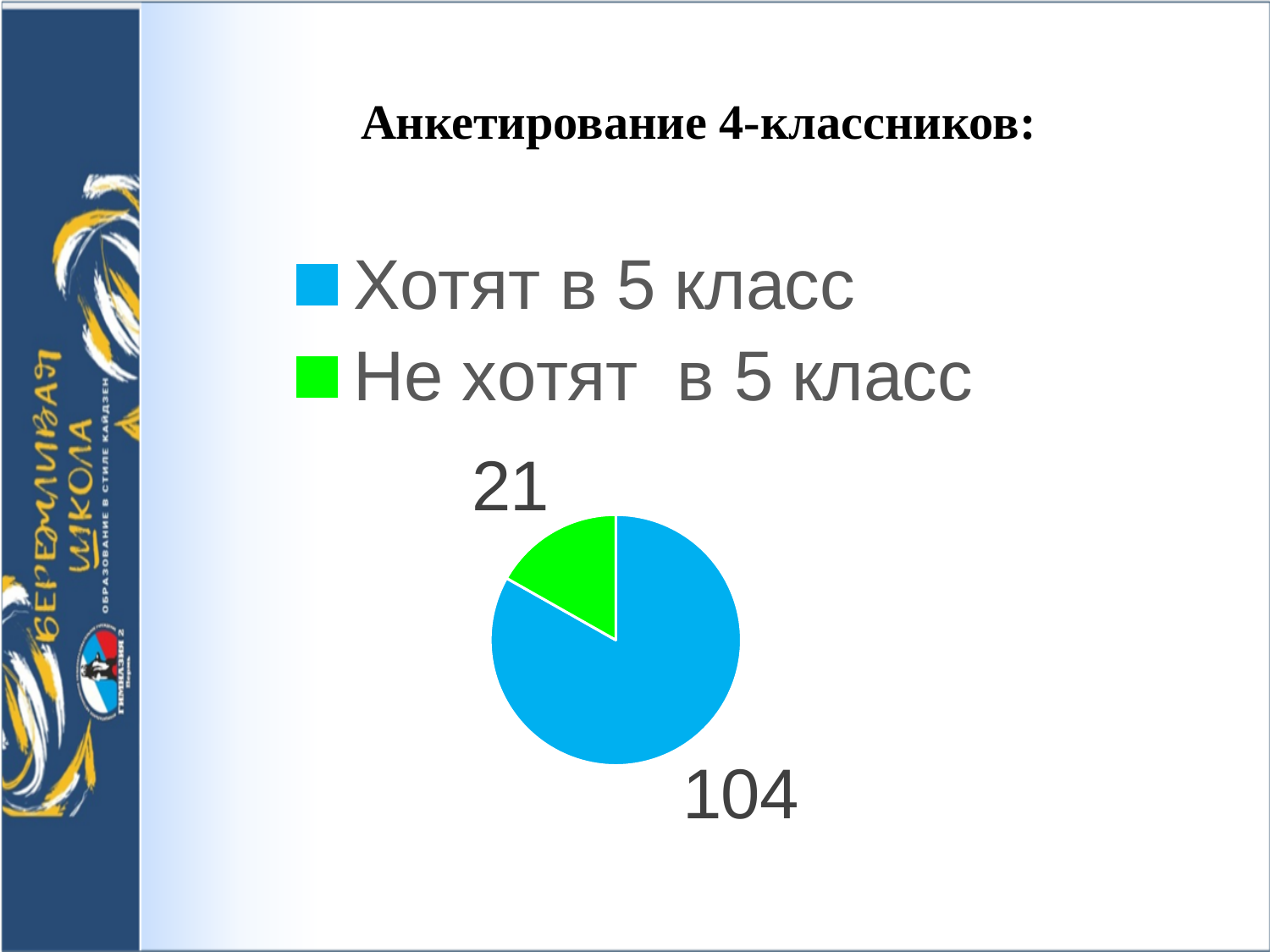
Which category has the smallest slice? Не хотят в 5 класс Which category has the largest slice? Хотят в 5 класс How many slices does the pie chart have? 2 What is the total of all slices in the pie chart? 125 Which is larger: "Хотят в 5 класс" or "Не хотят в 5 класс"? Хотят в 5 класс What is the value for "Хотят в 5 класс"? 104 How many entries does the legend list? 2 What kind of chart is shown on the slide? pie chart What is the value for "Не хотят в 5 класс"? 21 What is the difference between the values for "Хотят в 5 класс" and "Не хотят в 5 класс"? 83 What is the title of the chart? Анкетирование 4-классников: What colour is the slice for "Не хотят в 5 класс"? green